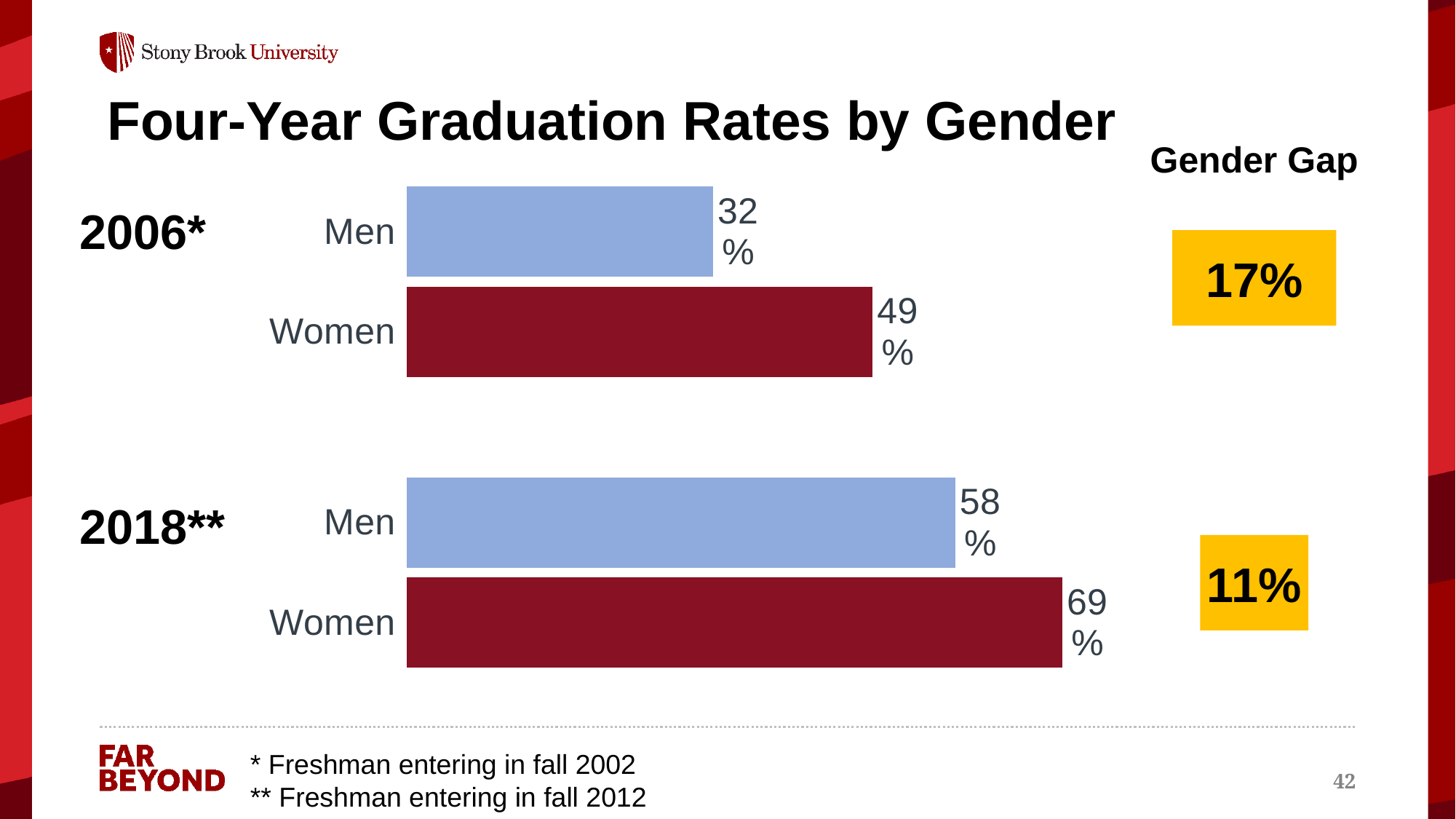
In the 2018 chart, what is the four-year graduation rate for Men? 58% In the 2006 chart, what is the four-year graduation rate for Women? 49% What colour are the bars for Women in both charts? Dark red In the 2018 chart, what is the difference between the Women's and Men's graduation rates? 11% What is the difference between the Men's graduation rate in 2018 and in 2006? 26% In the 2018 chart, which group has the lower graduation rate? Men In the 2018 chart, what is the four-year graduation rate for Women? 69% In the 2006 chart, what is the four-year graduation rate for Men? 32% How many bars are shown in the 2018 chart? 2 What type of chart is used to show the graduation rates on this slide? Bar chart In the 2006 chart, which group has the higher graduation rate, Men or Women? Women In the 2006 chart, what is the difference between the Women's and Men's graduation rates? 17%